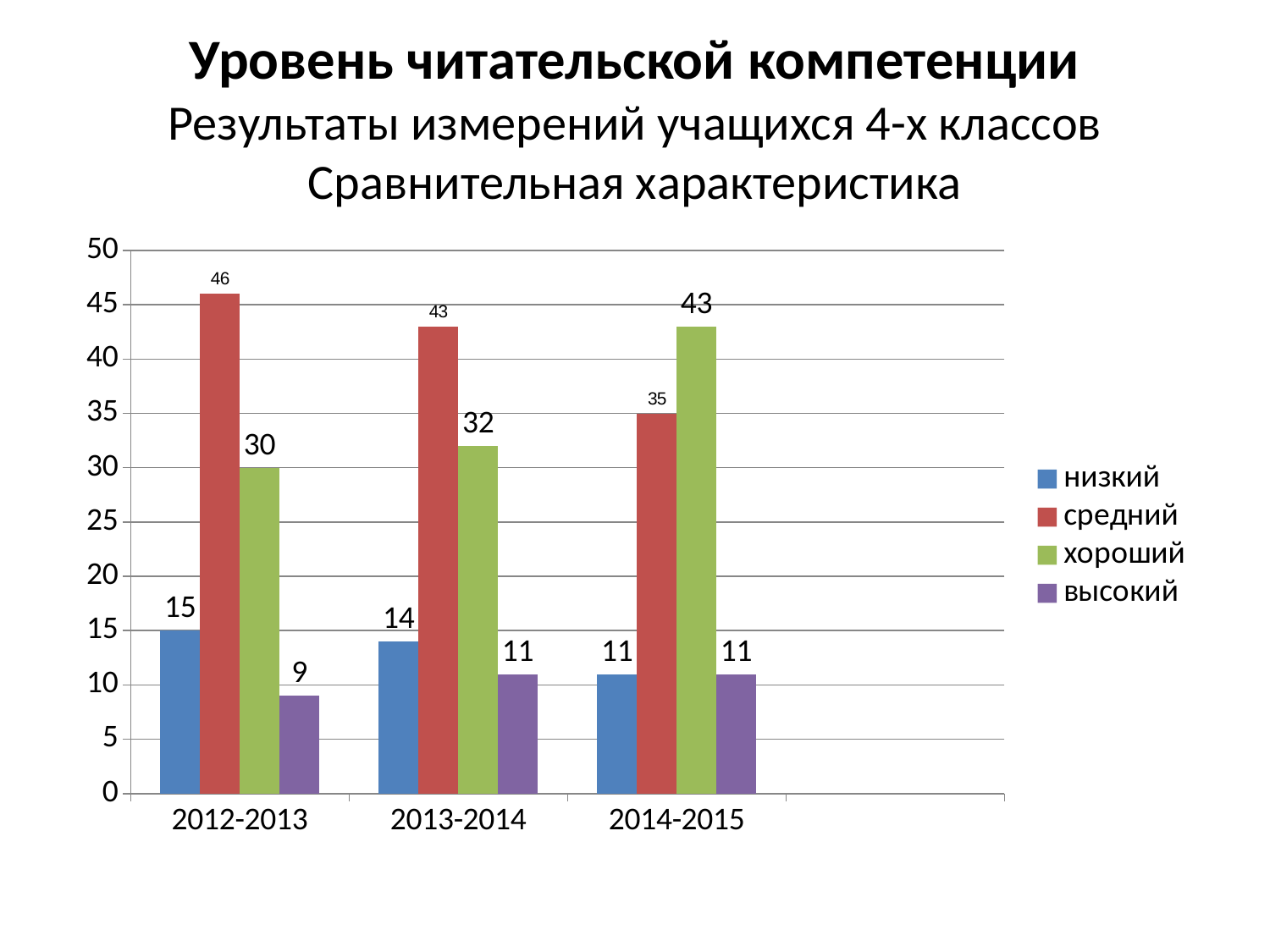
What kind of chart is shown on the slide? bar chart What is the value for "хороший" in 2014-2015? 43 What is the value for "средний" in 2012-2013? 46 Does the "хороший" series rise or fall from 2012-2013 to 2014-2015? rise How many series does the legend list? 4 What is the difference between the "средний" values for 2012-2013 and 2014-2015? 11 How many year categories are shown on the x axis? 3 Which series has the lowest value in 2012-2013? высокий Which series has the highest value in 2013-2014? средний What is the value for "низкий" in 2013-2014? 14 Which is larger in 2014-2015: "средний" or "хороший"? хороший What is the value for "высокий" in 2012-2013? 9